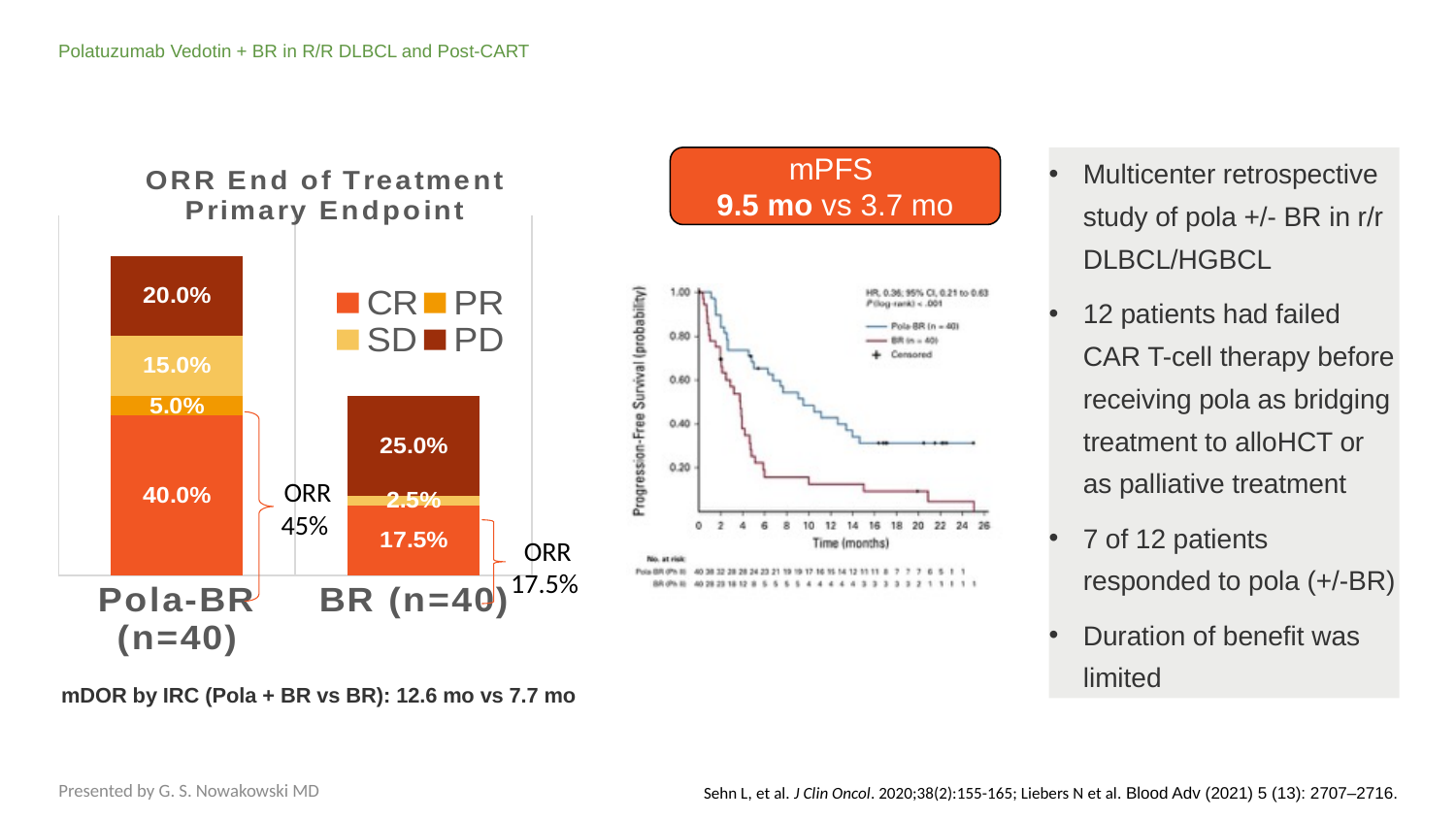
How many categories are shown on the x axis of the ORR End of Treatment Primary Endpoint chart? 2 In the ORR End of Treatment Primary Endpoint chart, what is the total of the stacked bar for Pola-BR (n=40)? 80.0% In the ORR End of Treatment Primary Endpoint chart, which category has the larger CR value, Pola-BR (n=40) or BR (n=40)? Pola-BR (n=40) In the ORR End of Treatment Primary Endpoint chart, what is the difference between the CR values for Pola-BR (n=40) and BR (n=40)? 22.5% What is the x-axis label of the Progression-Free Survival chart in the middle of the slide? Time (months) How many series does the legend of the ORR End of Treatment Primary Endpoint chart list? 4 What kind of chart is the ORR End of Treatment Primary Endpoint chart? Stacked bar chart In the ORR End of Treatment Primary Endpoint chart, what is the CR value for Pola-BR (n=40)? 40.0% In the ORR End of Treatment Primary Endpoint chart, what is the PD value for BR (n=40)? 25.0% In the ORR End of Treatment Primary Endpoint chart, what is the PD value for Pola-BR (n=40)? 20.0% In the ORR End of Treatment Primary Endpoint chart, what is the SD value for Pola-BR (n=40)? 15.0%